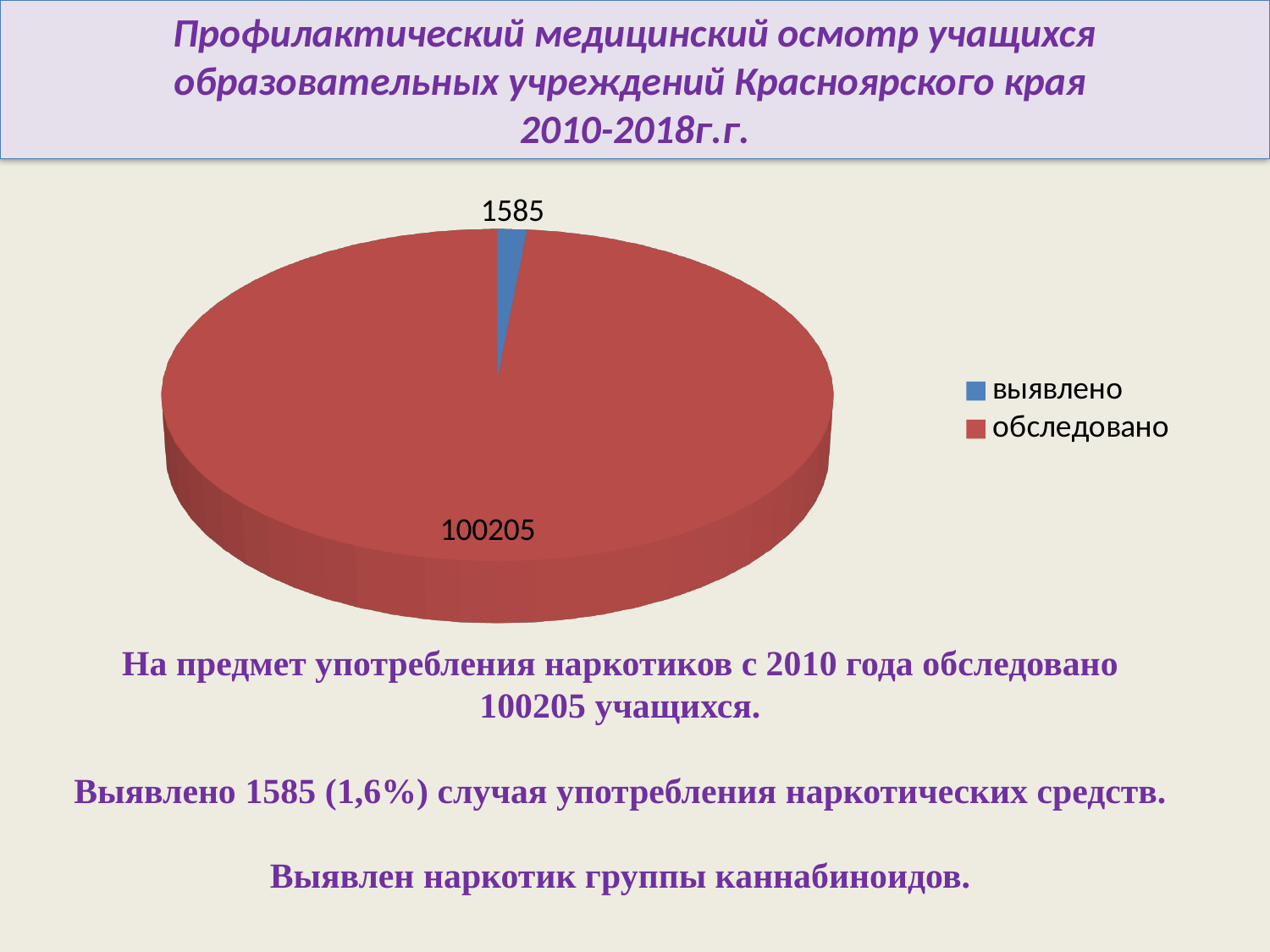
What colour is the slice for "выявлено"? blue What is the value for the slice labelled "выявлено"? 1585 Which slice of the pie is the smallest? выявлено What is the value for the slice labelled "обследовано"? 100205 What kind of chart is shown on the slide? pie chart Which is larger, the value for "выявлено" or the value for "обследовано"? обследовано What is the difference between the values for "обследовано" and "выявлено"? 98620 How many entries does the legend list? 2 Which slice of the pie is the largest? обследовано How many slices does the pie chart have? 2 What colour is the slice for "обследовано"? red What is the sum of the two values shown on the pie chart? 101790